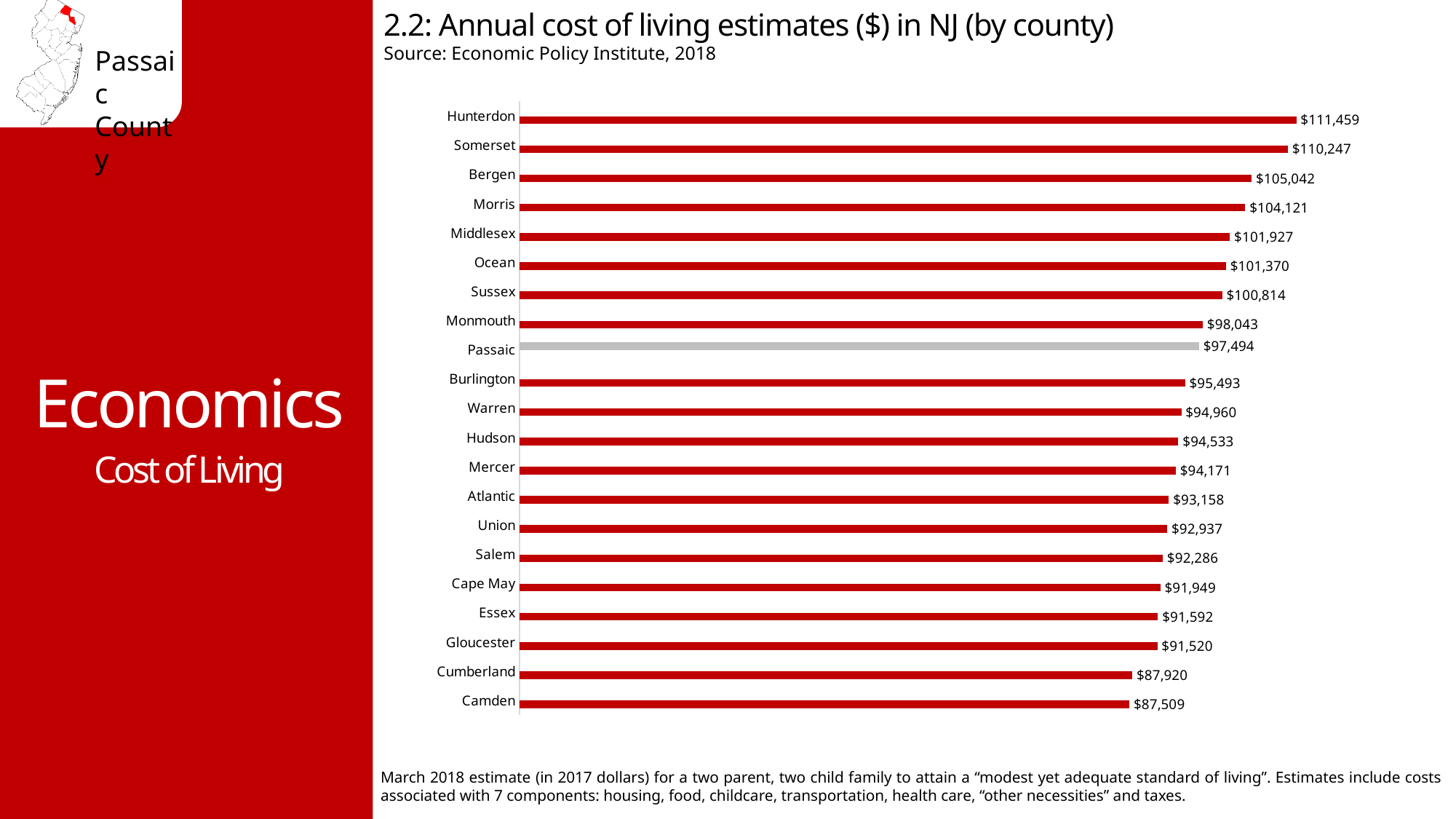
What is the source cited for the chart? Economic Policy Institute, 2018 What is the annual cost of living estimate for Passaic county? $97,494 What is the annual cost of living estimate for Bergen county? $105,042 Which county's bar is shown in a different colour (grey) from the others? Passaic What is the annual cost of living estimate for Camden county? $87,509 Which county has the highest annual cost of living estimate? Hunterdon What kind of chart is shown on the slide? Bar chart Which county has the lowest annual cost of living estimate? Camden What is the difference between the cost of living estimates for Hunterdon and Camden? $23,950 Which county has a higher cost of living estimate, Morris or Ocean? Morris What is the difference between the cost of living estimates for Monmouth and Passaic? $549 How many counties are shown in the chart? 21